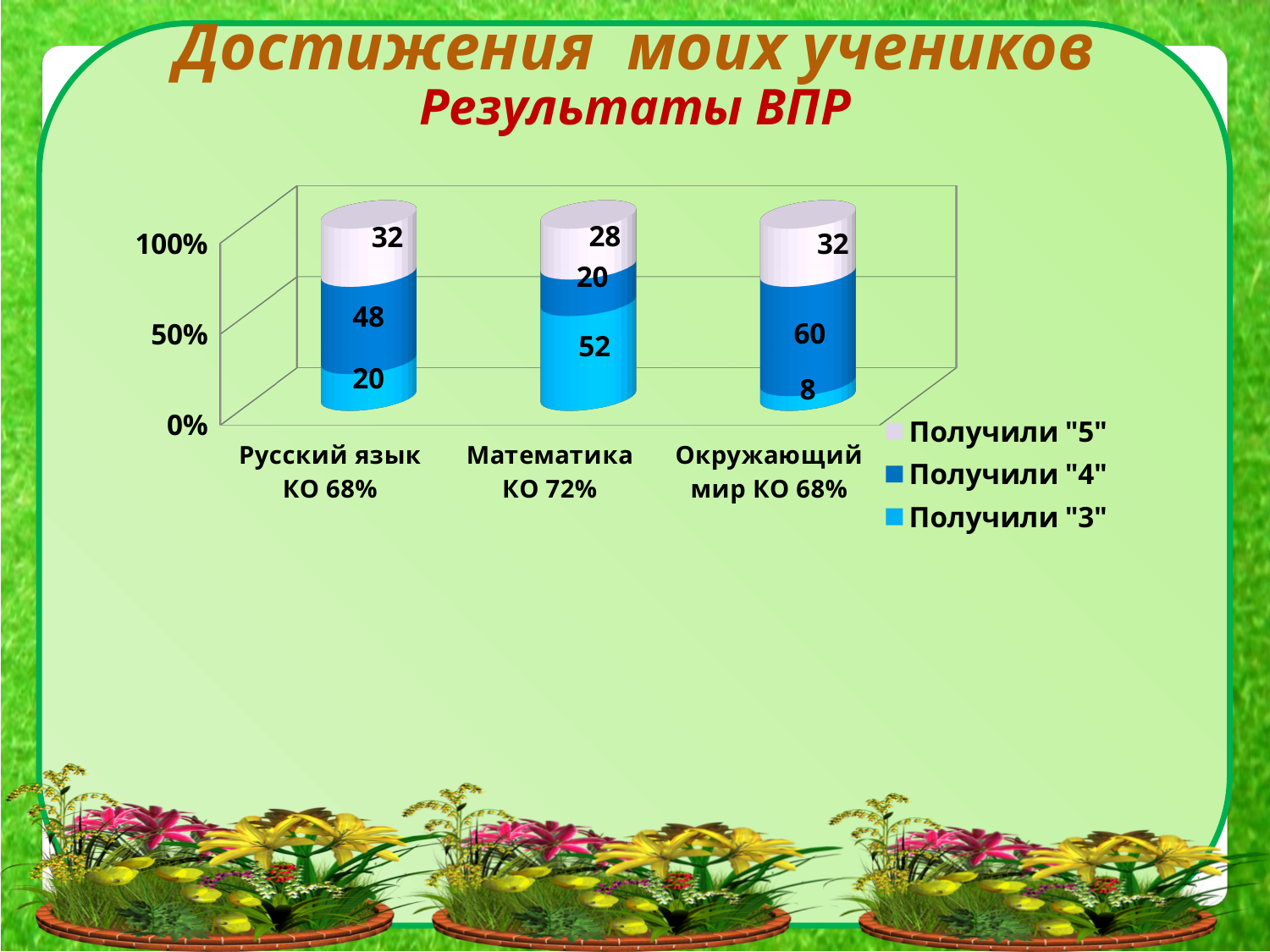
Which is larger: Получили "4" for Русский язык КО 68% or Получили "4" for Математика КО 72%? Русский язык КО 68% How many categories are shown on the x axis? 3 How many series does the legend list? 3 What is the difference between the Получили "3" values for Математика КО 72% and Русский язык КО 68%? 32 What value is shown for Получили "3" in the Окружающий мир КО 68% bar? 8 Which category has the lowest value for Получили "5"? Математика КО 72% What value is shown for Получили "3" in the Математика КО 72% bar? 52 What kind of chart is shown on the slide? Stacked bar chart What value is shown for Получили "4" in the Русский язык КО 68% bar? 48 What value is shown for Получили "5" in the Окружающий мир КО 68% bar? 32 Which category has the highest value for Получили "4"? Окружающий мир КО 68% What is the total of the stacked bar for Математика КО 72%? 100